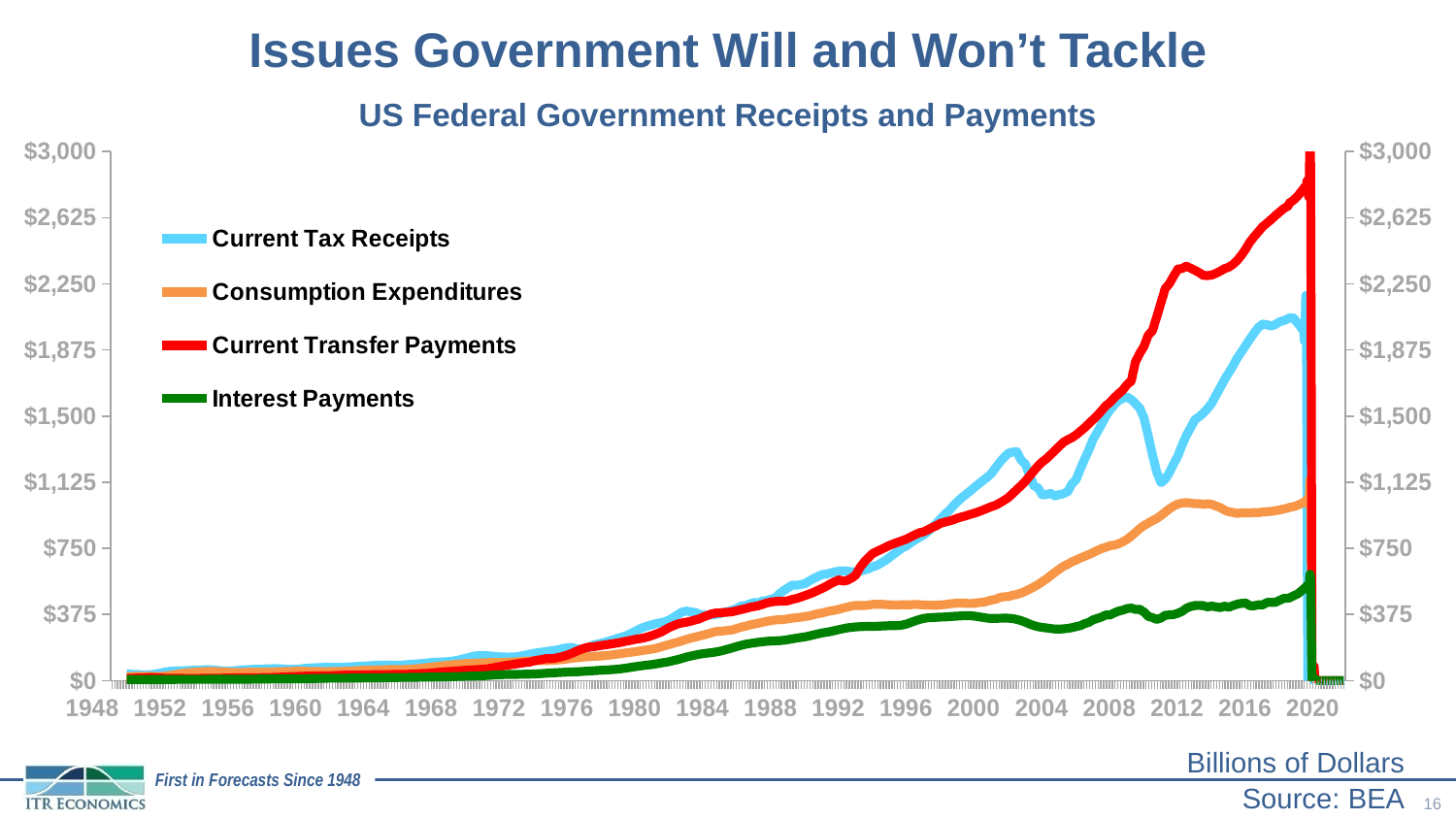
Is the value for Consumption Expenditures in 2012 greater or less than $750? greater What colour is the Interest Payments line? green Do Consumption Expenditures generally rise or fall from 1948 to 2016? rise How many series does the legend list? 4 What kind of chart is shown on the slide? line chart Which series reaches the highest value on the chart? Current Transfer Payments Is the value for Interest Payments in 1980 greater or less than $375? less What is the title of the chart? US Federal Government Receipts and Payments Which series has the lowest values across the chart? Interest Payments Is the value for Interest Payments in 2016 greater or less than $375? greater In 2016, which is larger: Current Transfer Payments or Current Tax Receipts? Current Transfer Payments